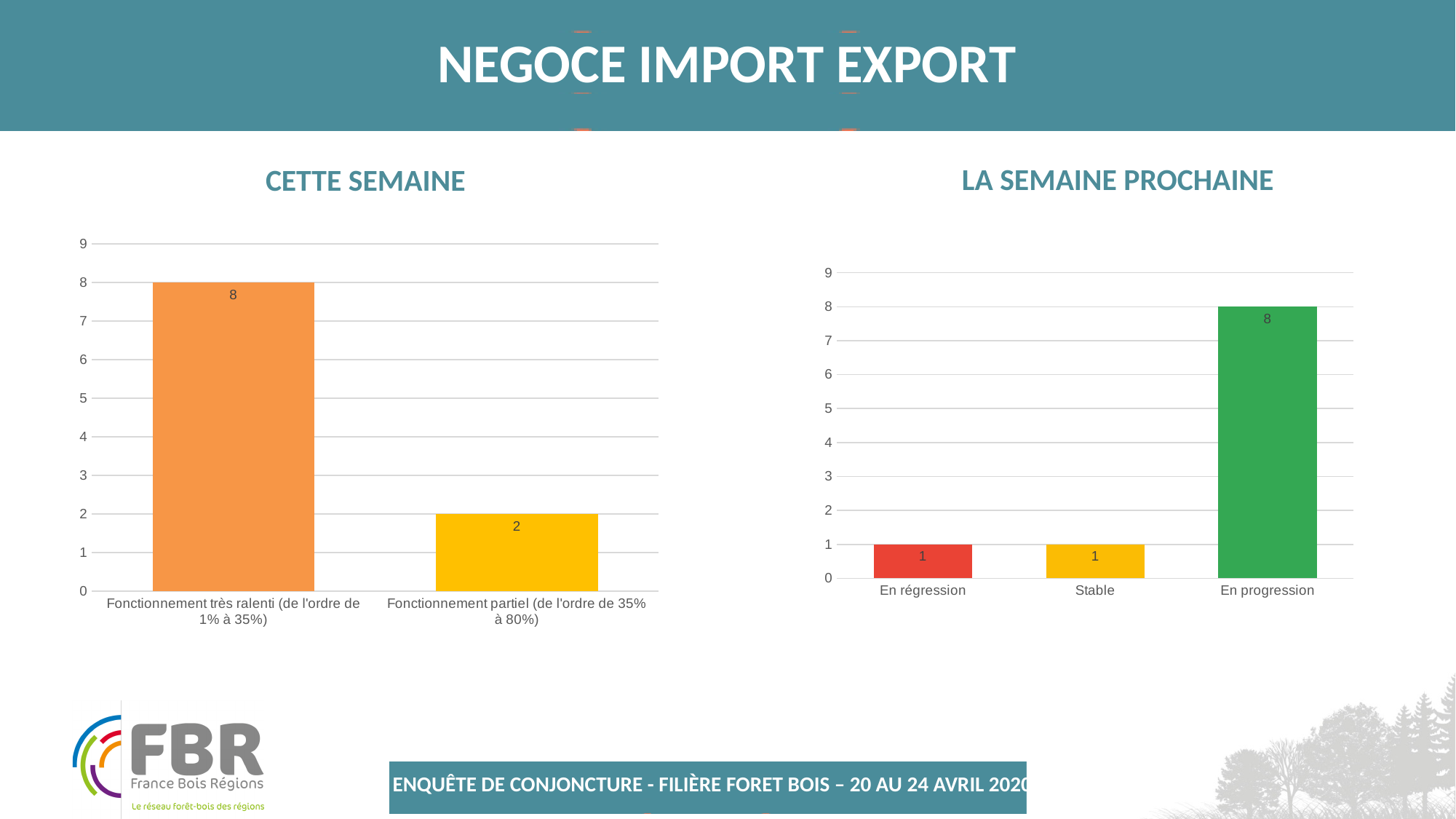
In the 'LA SEMAINE PROCHAINE' chart, what colour is the 'En progression' bar? Green In the 'LA SEMAINE PROCHAINE' chart, how many categories are shown? 3 In the 'LA SEMAINE PROCHAINE' chart, what is the value for 'En progression'? 8 In the 'CETTE SEMAINE' chart, how many categories are shown? 2 In the 'LA SEMAINE PROCHAINE' chart, what is the difference between 'En progression' and 'En régression'? 7 What kind of chart is the 'LA SEMAINE PROCHAINE' chart? Bar chart In the 'LA SEMAINE PROCHAINE' chart, what is the value for 'Stable'? 1 In the 'CETTE SEMAINE' chart, what is the difference between the two bars? 6 In the 'CETTE SEMAINE' chart, what is the value for 'Fonctionnement partiel (de l'ordre de 35% à 80%)'? 2 In the 'LA SEMAINE PROCHAINE' chart, which category has the highest value? En progression In the 'CETTE SEMAINE' chart, what is the value for 'Fonctionnement très ralenti (de l'ordre de 1% à 35%)'? 8 In the 'CETTE SEMAINE' chart, which category has the highest value? Fonctionnement très ralenti (de l'ordre de 1% à 35%)